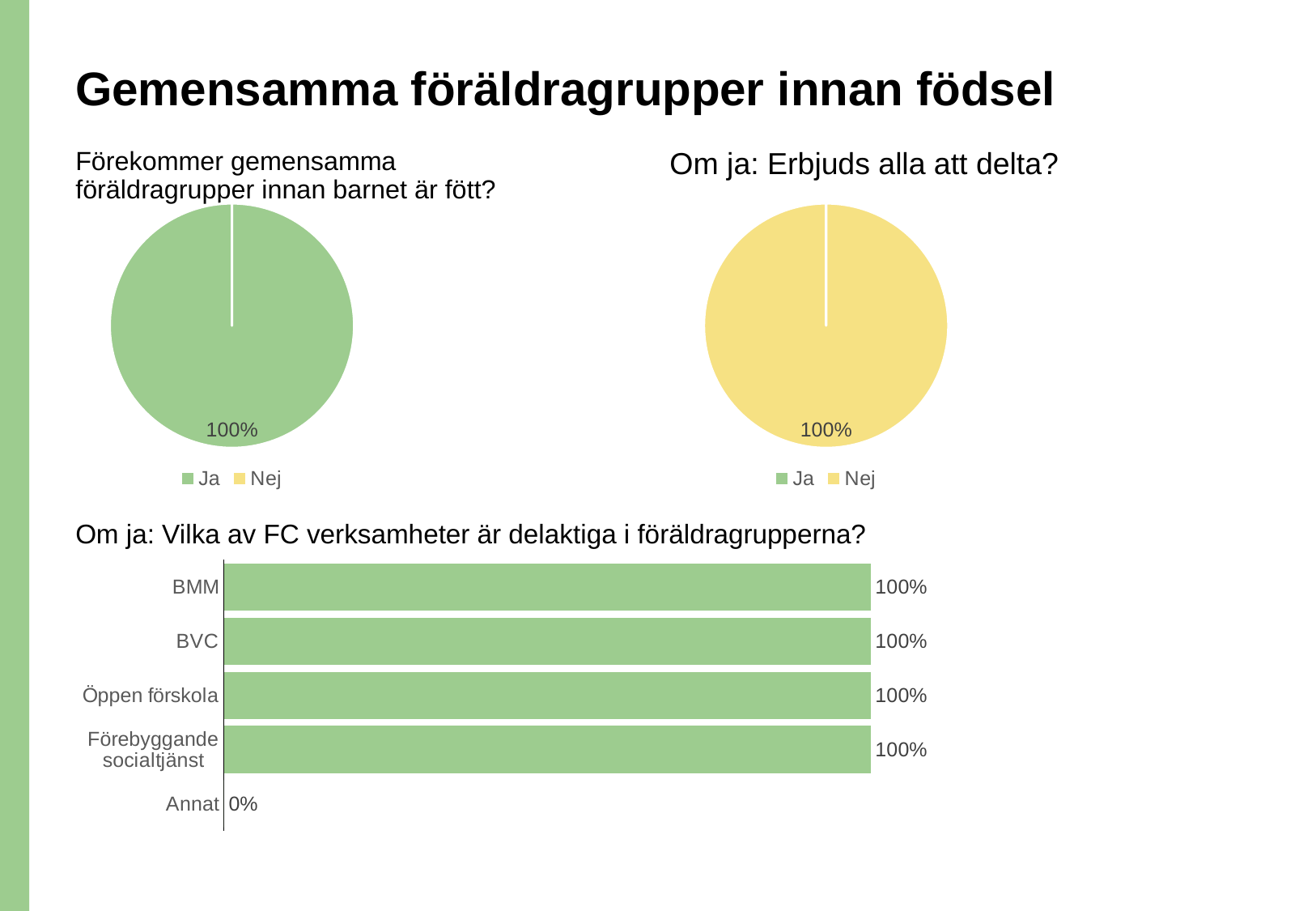
In the bar chart titled 'Om ja: Vilka av FC verksamheter är delaktiga i föräldragrupperna?', which is larger, the value for Öppen förskola or the value for Annat? Öppen förskola In the pie chart titled 'Om ja: Erbjuds alla att delta?', what share does the Nej slice have? 100% In the bar chart titled 'Om ja: Vilka av FC verksamheter är delaktiga i föräldragrupperna?', what is the value for BVC? 100% In the pie chart titled 'Om ja: Erbjuds alla att delta?', which legend entry does the single slice belong to? Nej In the pie chart titled 'Förekommer gemensamma föräldragrupper innan barnet är fött?', how many series does the legend list? 2 In the pie chart titled 'Förekommer gemensamma föräldragrupper innan barnet är fött?', what share does the Ja slice have? 100% In the bar chart titled 'Om ja: Vilka av FC verksamheter är delaktiga i föräldragrupperna?', what is the difference between the values for BMM and Annat? 100% What kind of chart is the chart titled 'Om ja: Vilka av FC verksamheter är delaktiga i föräldragrupperna?'? bar chart In the bar chart titled 'Om ja: Vilka av FC verksamheter är delaktiga i föräldragrupperna?', how many categories are shown? 5 In the bar chart titled 'Om ja: Vilka av FC verksamheter är delaktiga i föräldragrupperna?', what is the value for Annat? 0% What kind of chart is the chart titled 'Om ja: Erbjuds alla att delta?'? pie chart In the bar chart titled 'Om ja: Vilka av FC verksamheter är delaktiga i föräldragrupperna?', which category has the lowest value? Annat